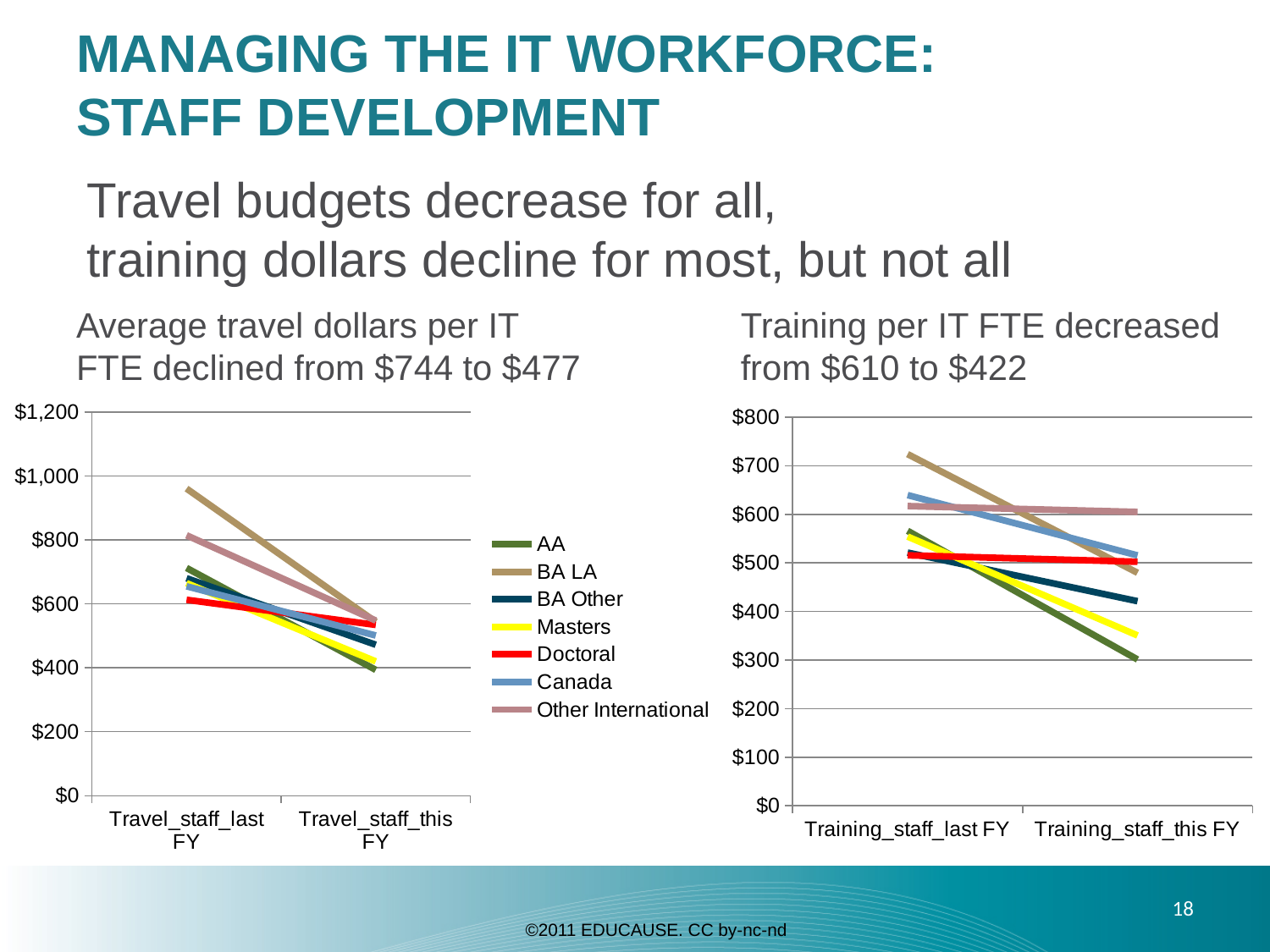
In the right chart (training per IT FTE), is the value for AA at Training_staff_this FY greater or less than $400? less In the right chart (training per IT FTE), at Training_staff_last FY, which is larger: BA LA or Doctoral? BA LA In the right chart (training per IT FTE), is the value for Other International at Training_staff_this FY greater or less than $500? greater In the right chart (training per IT FTE), which series has the lowest value at Training_staff_this FY? AA How many series does the legend between the two charts list? 7 In the left chart (travel dollars), how many categories are shown on the x axis? 2 In the left chart (travel dollars), is the value for BA LA at Travel_staff_last FY greater or less than $800? greater What kind of chart is the left chart, 'Average travel dollars per IT FTE declined from $744 to $477'? line chart In the left chart (travel dollars), which series has the highest value at Travel_staff_last FY? BA LA In the right chart (training per IT FTE), which series has the highest value at Training_staff_last FY? BA LA What is the title of the left chart? Average travel dollars per IT FTE declined from $744 to $477 In the right chart (training per IT FTE), does the BA LA line rise or fall from Training_staff_last FY to Training_staff_this FY? fall